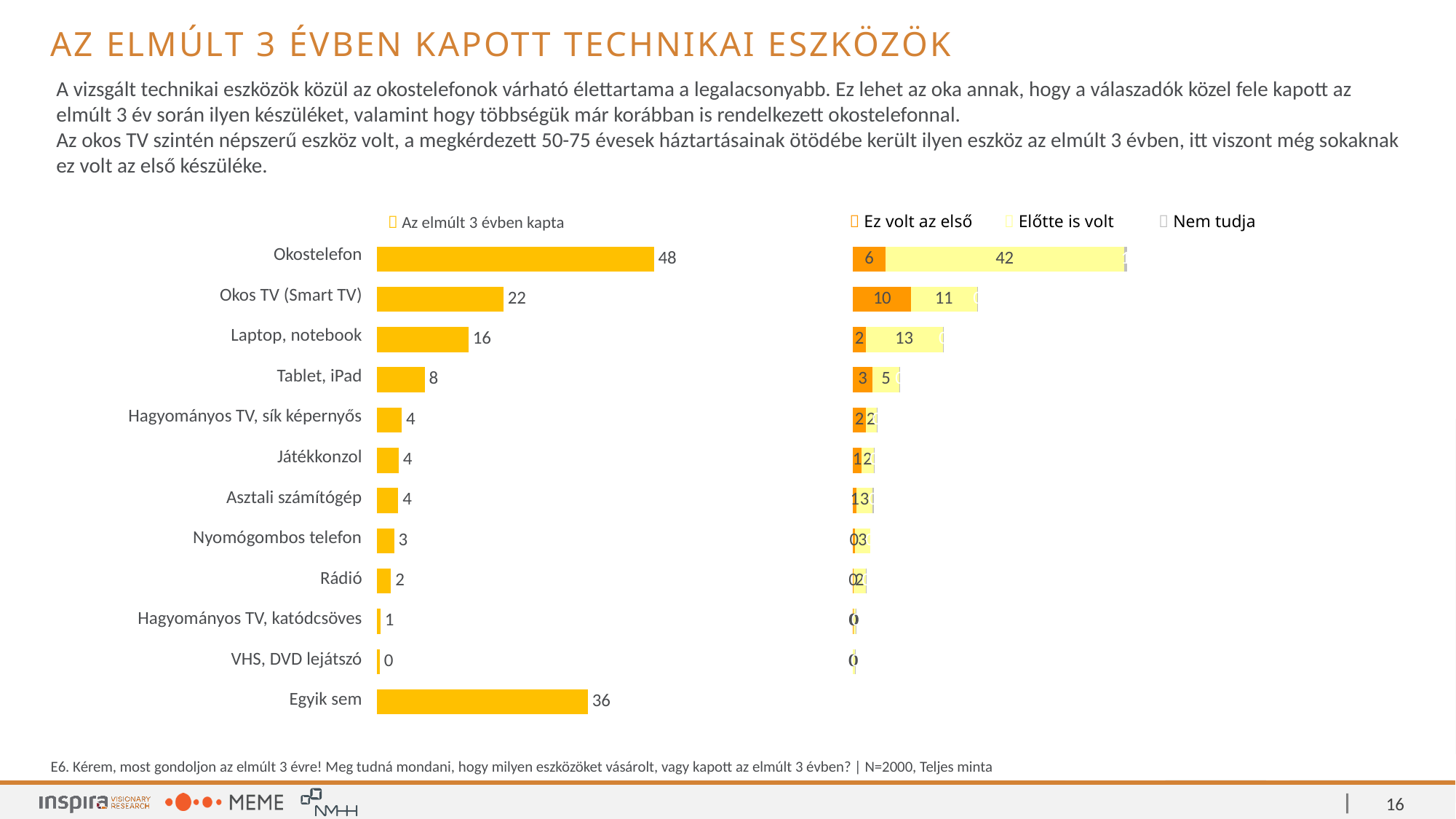
In the right chart, what is the 'Előtte is volt' value for Okostelefon? 42 In the left chart (Az elmúlt 3 évben kapta), which category has the lowest value? VHS, DVD lejátszó In the left chart (Az elmúlt 3 évben kapta), which category has the highest value? Okostelefon In the left chart (Az elmúlt 3 évben kapta), which is larger: Laptop, notebook or Tablet, iPad? Laptop, notebook In the left chart (Az elmúlt 3 évben kapta), what is the difference between Okostelefon and Okos TV (Smart TV)? 26 How many series does the legend of the right chart list? 3 In the left chart (Az elmúlt 3 évben kapta), what is the value for Okostelefon? 48 In the left chart (Az elmúlt 3 évben kapta), what is the value for Egyik sem? 36 In the right chart, which category has the highest 'Ez volt az első' value? Okos TV (Smart TV) In the right chart, what is the 'Ez volt az első' value for Okos TV (Smart TV)? 10 How many categories are listed in the left chart (Az elmúlt 3 évben kapta)? 12 What kind of chart is the left chart (Az elmúlt 3 évben kapta)? Bar chart